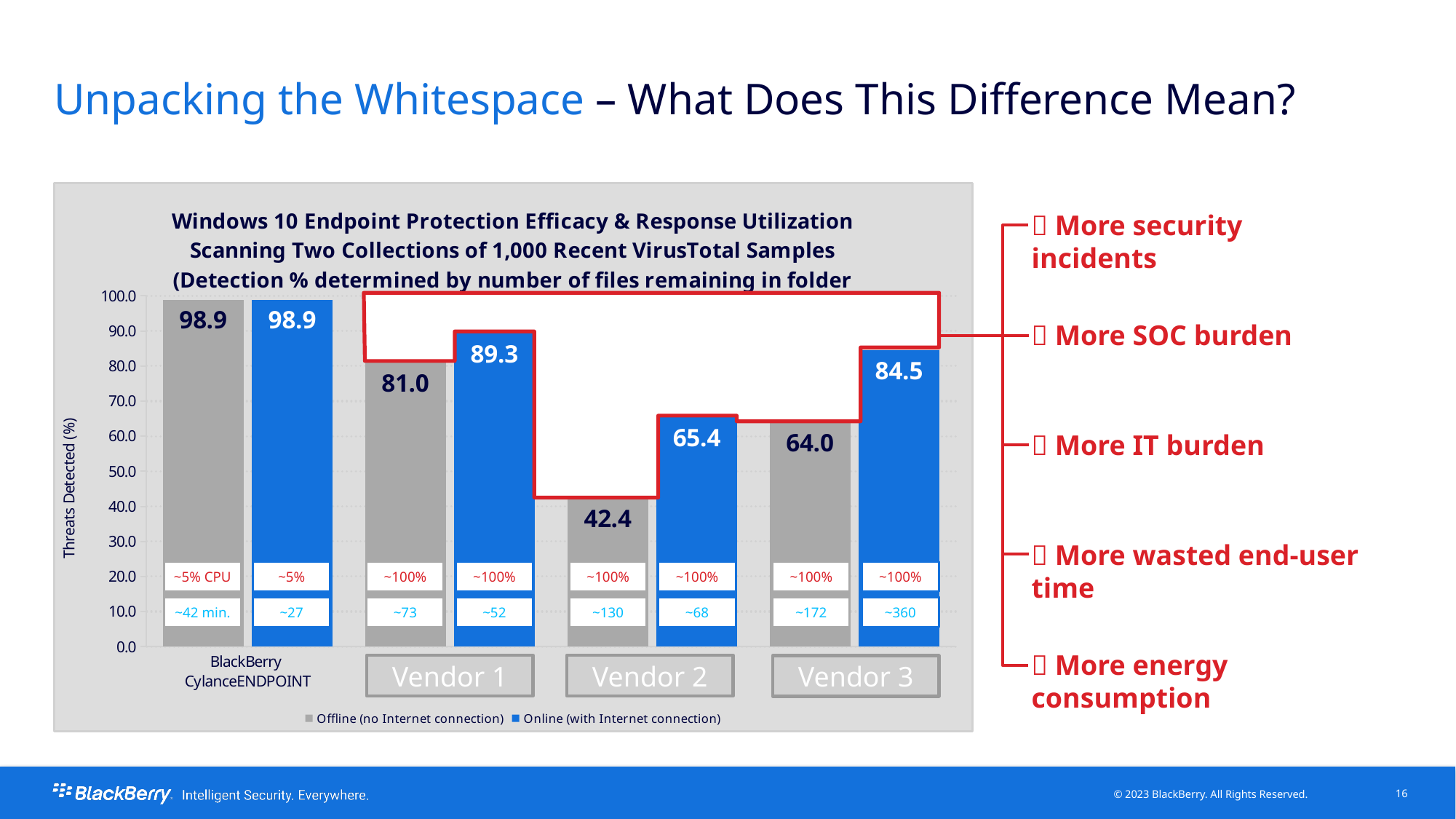
What is the Online (with Internet connection) value for Vendor 3? 84.5 How many categories are shown on the x axis of the chart? 4 Which is larger: the Offline value for Vendor 1 or the Online value for Vendor 3? Online value for Vendor 3 Which category has the lowest Offline (no Internet connection) detection value? Vendor 2 Is the Offline (no Internet connection) value for Vendor 3 greater or less than 70.0? less Which category has the highest Online (with Internet connection) detection value? BlackBerry CylanceENDPOINT What is the Offline (no Internet connection) threats detected value for Vendor 2? 42.4 What is the Online (with Internet connection) threats detected value for Vendor 1? 89.3 What type of chart is shown on the slide? Bar chart What is the difference between the Online and Offline detection values for Vendor 2? 23.0 How many series does the chart legend list? 2 What is the difference between the Offline detection values for Vendor 1 and Vendor 3? 17.0